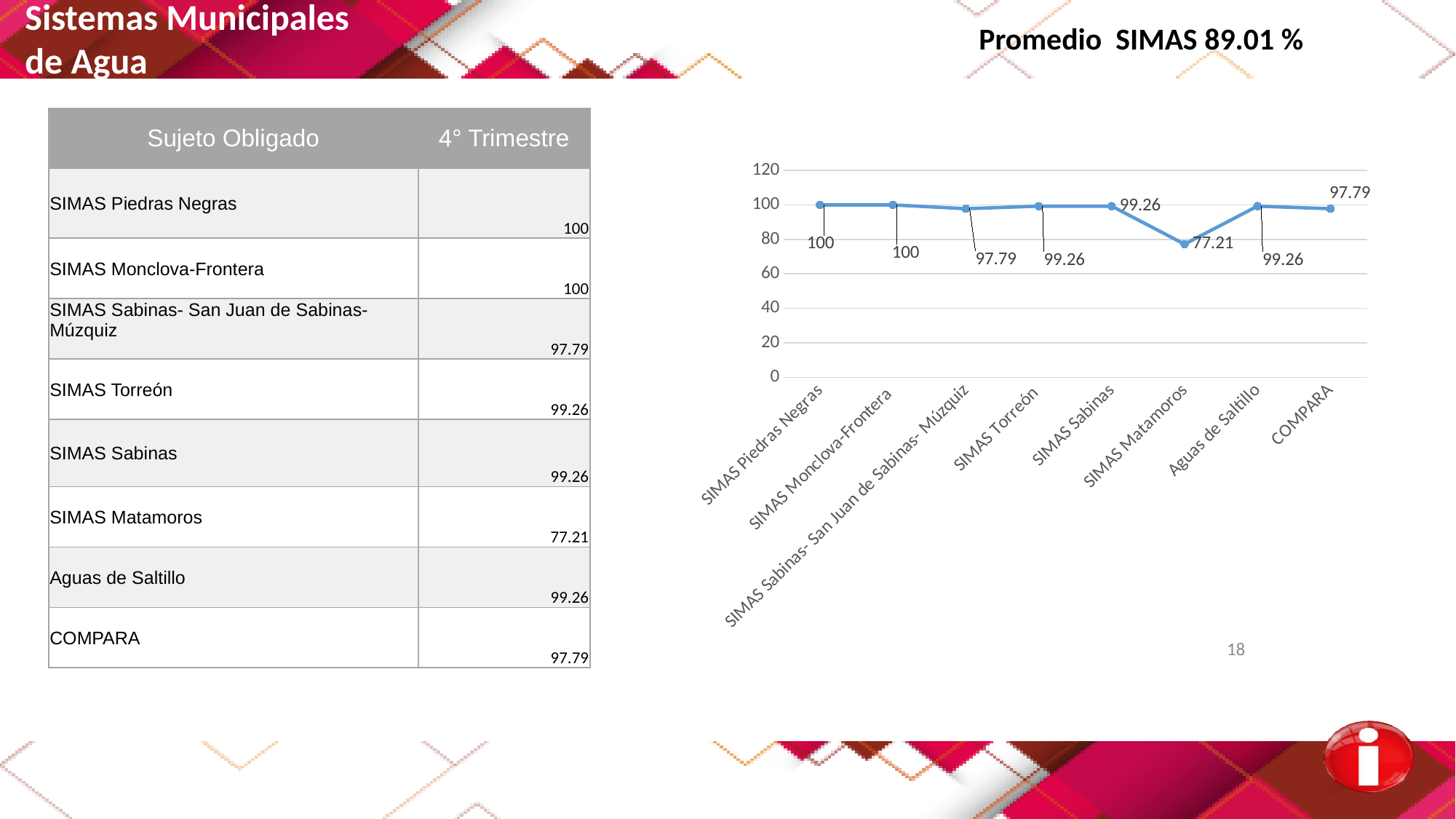
How many categories are plotted on the chart? 8 What is the highest value shown on the vertical axis of the chart? 120 What is the value plotted for COMPARA? 97.79 What is the difference between the values for Aguas de Saltillo and COMPARA? 1.47 What kind of chart is shown on the slide? line chart What is the difference between the values for SIMAS Piedras Negras and SIMAS Matamoros? 22.79 What is the value plotted for SIMAS Matamoros? 77.21 Which category has the lowest value on the chart? SIMAS Matamoros What is the value plotted for SIMAS Torreón? 99.26 Which is larger, the value for SIMAS Sabinas or the value for SIMAS Matamoros? SIMAS Sabinas Is the value for SIMAS Matamoros greater or less than 80? less What is the value plotted for SIMAS Piedras Negras? 100